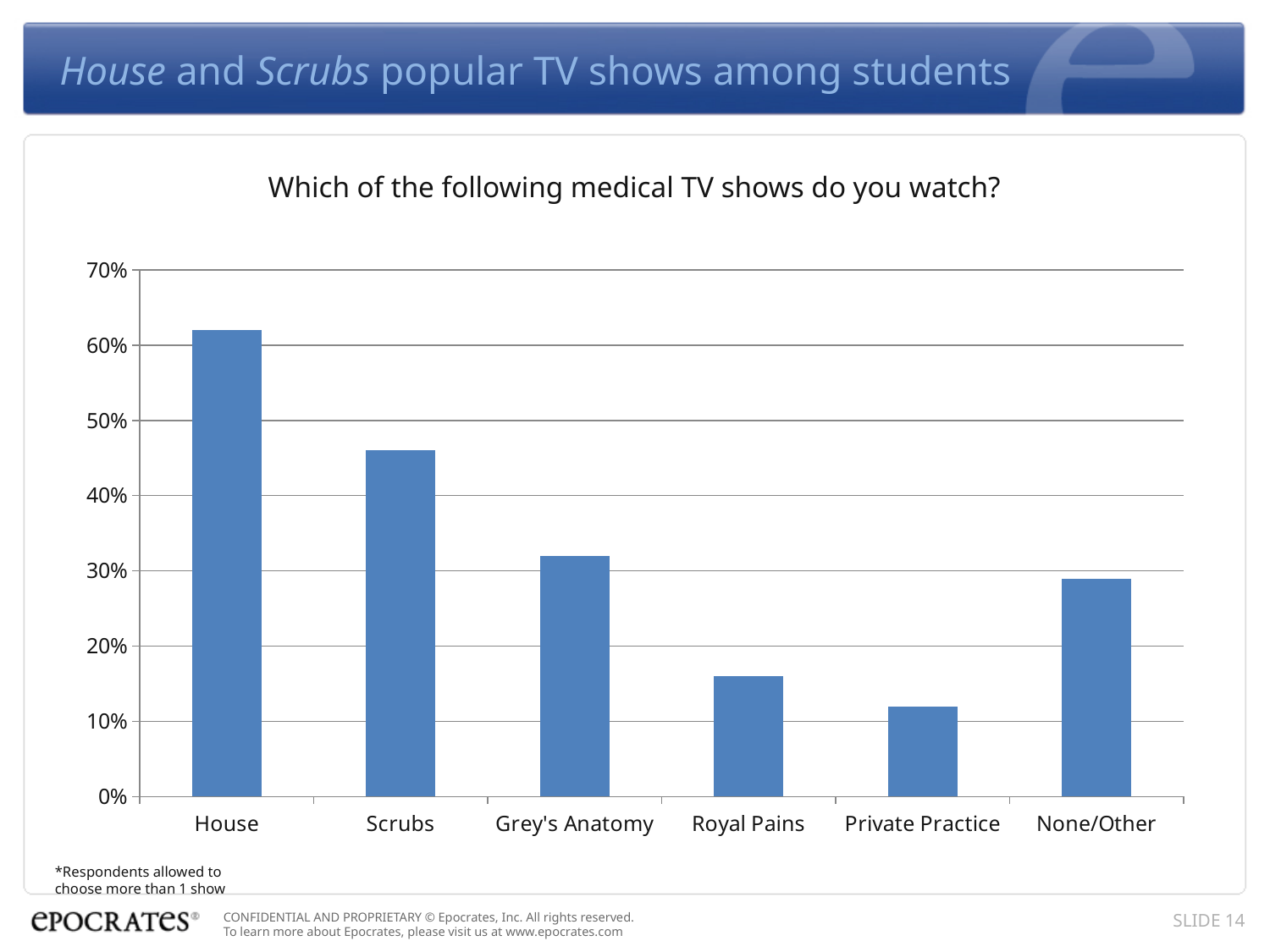
How many TV show categories are shown on the x axis? 6 Which is larger, the value for Royal Pains or the value for Grey's Anatomy? Grey's Anatomy Which is larger, the value for Scrubs or the value for None/Other? Scrubs Which TV show has the lowest bar? Private Practice Is the value for Scrubs greater or less than 50%? less What kind of chart is shown on the slide? bar chart Is the value for Private Practice greater or less than 10%? greater Which TV show has the highest bar? House Is the value for Grey's Anatomy greater or less than 40%? less What question is shown as the chart title? Which of the following medical TV shows do you watch?